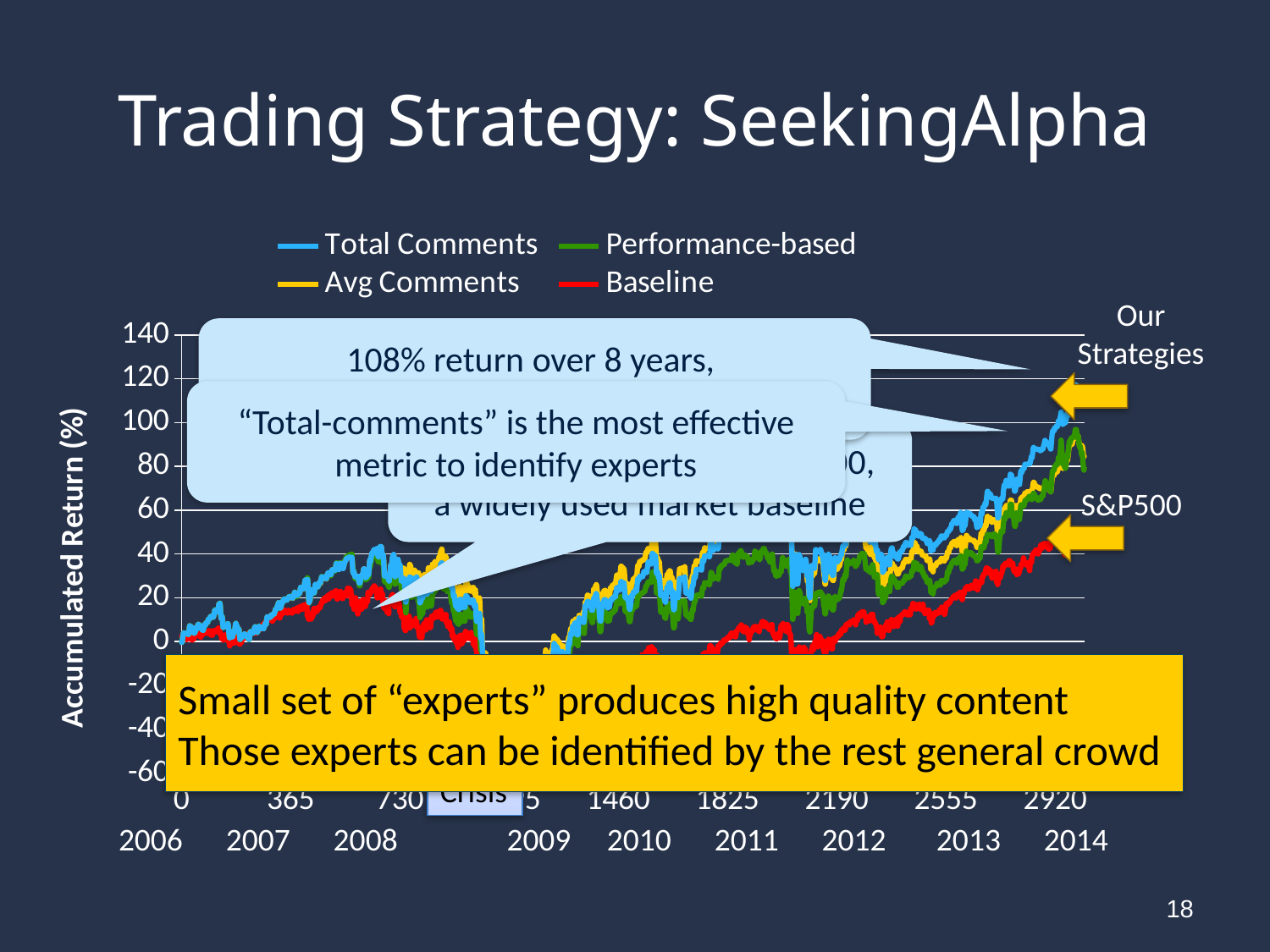
Which series is lowest at the right end of the chart (2014)? Baseline Which series ends highest at the right end of the chart (2014)? Total Comments What kind of chart is shown on the slide? line chart How many series does the chart legend list? 4 At the right end of the chart, which is larger: the Total Comments value or the Baseline value? Total Comments What is the label of the y axis of the chart? Accumulated Return (%) Does the Baseline series rise or fall overall from 2006 to 2014? rise How many year labels are shown along the x axis? 9 What colour is the Baseline series drawn in? red At the right end of the chart, is the value for Total Comments greater or less than 80? greater What is the highest tick value shown on the y axis? 140 At the right end of the chart, is the value for Baseline greater or less than 60? less